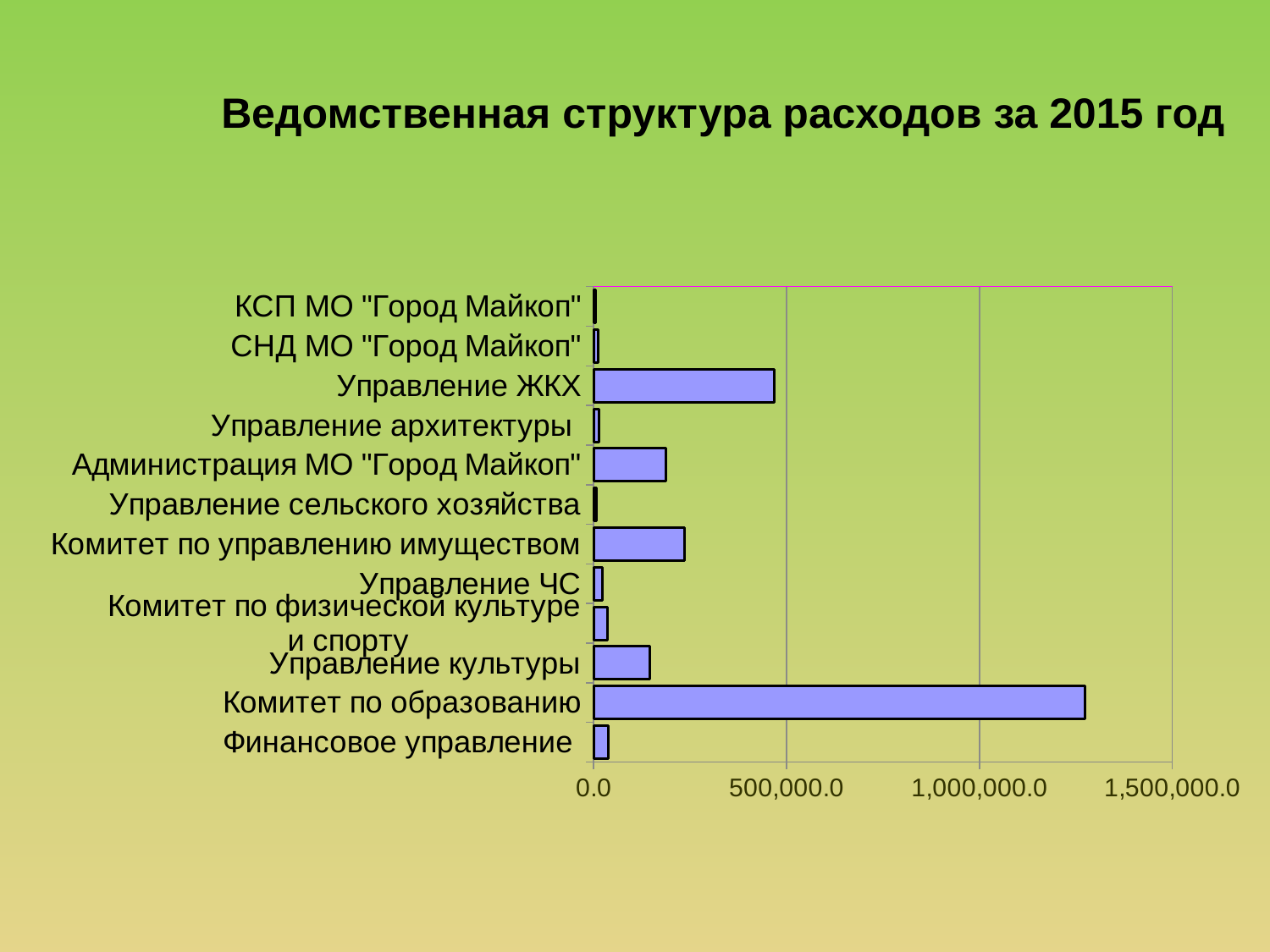
Is the value for Комитет по образованию greater or less than 1,000,000.0? greater Which is larger: the value for Управление ЖКХ or the value for Администрация МО "Город Майкоп"? Управление ЖКХ Is the value for Комитет по управлению имуществом greater or less than 500,000.0? less Which is larger: the value for Комитет по управлению имуществом or the value for Управление культуры? Комитет по управлению имуществом Which category has the highest value in the chart? Комитет по образованию Is the value for Управление ЖКХ greater or less than 500,000.0? less What is the title of the chart? Ведомственная структура расходов за 2015 год What kind of chart is shown on the slide? bar chart Which is larger: the value for Комитет по образованию or the value for Управление ЖКХ? Комитет по образованию How many categories (departments) are plotted in the chart? 12 What is the largest tick value shown on the horizontal axis? 1,500,000.0